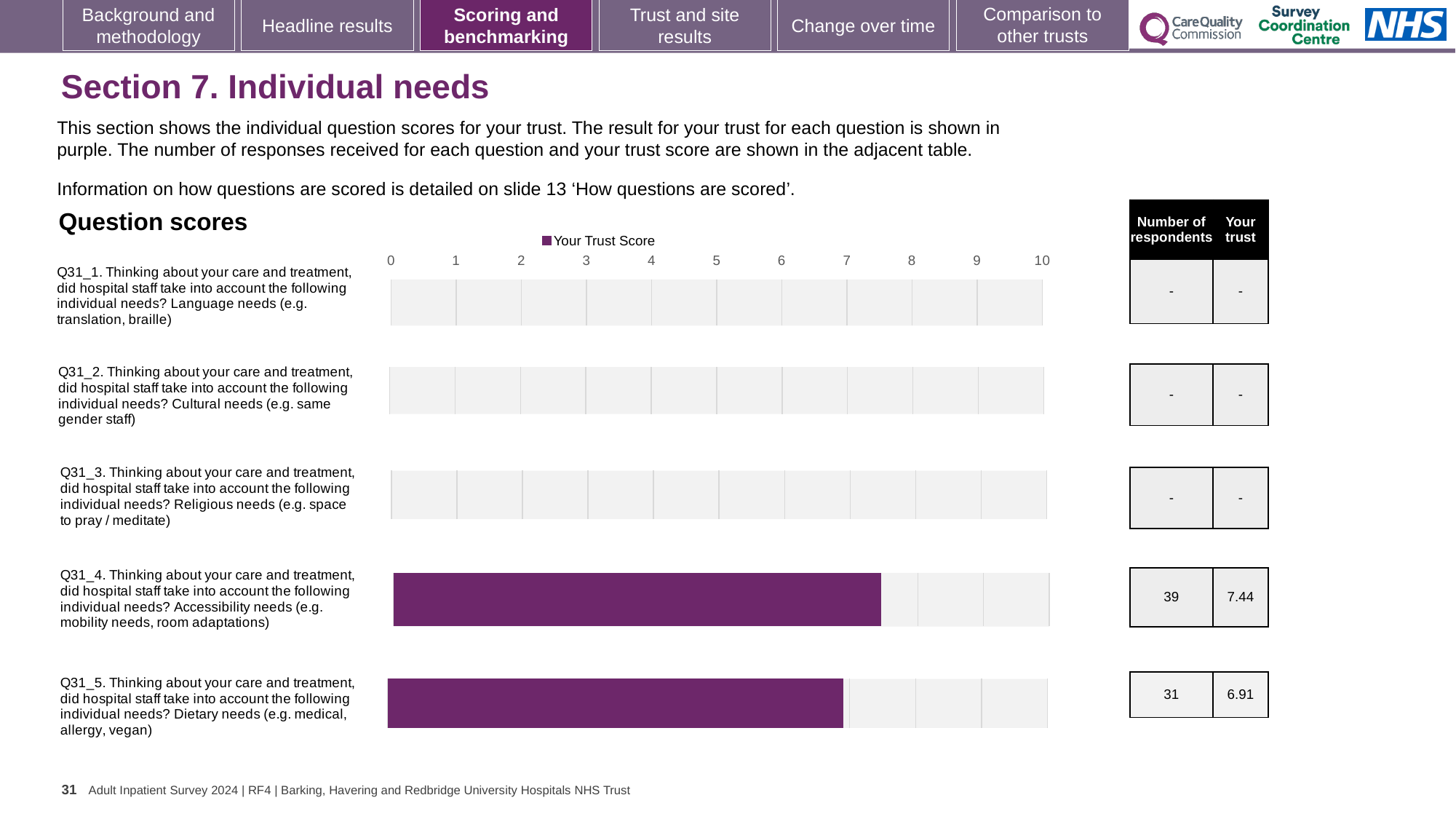
What type of chart is shown on the slide? Bar chart How many series does the chart legend list? 1 Which question has the highest trust score shown on the chart? Q31_4 (Accessibility needs) How many respondents answered Q31_5 (Dietary needs)? 31 How many respondents answered Q31_4 (Accessibility needs)? 39 Which has the larger trust score, Q31_4 (Accessibility needs) or Q31_5 (Dietary needs)? Q31_4 (Accessibility needs) What is the difference between the trust scores for Q31_4 and Q31_5? 0.53 How many questions are listed on the chart? 5 What is the trust score for Q31_5 (Dietary needs)? 6.91 What is the name of the series shown in the chart legend? Your Trust Score Is the trust score for Q31_5 (Dietary needs) greater or less than 7? less What is the trust score for Q31_4 (Accessibility needs)? 7.44